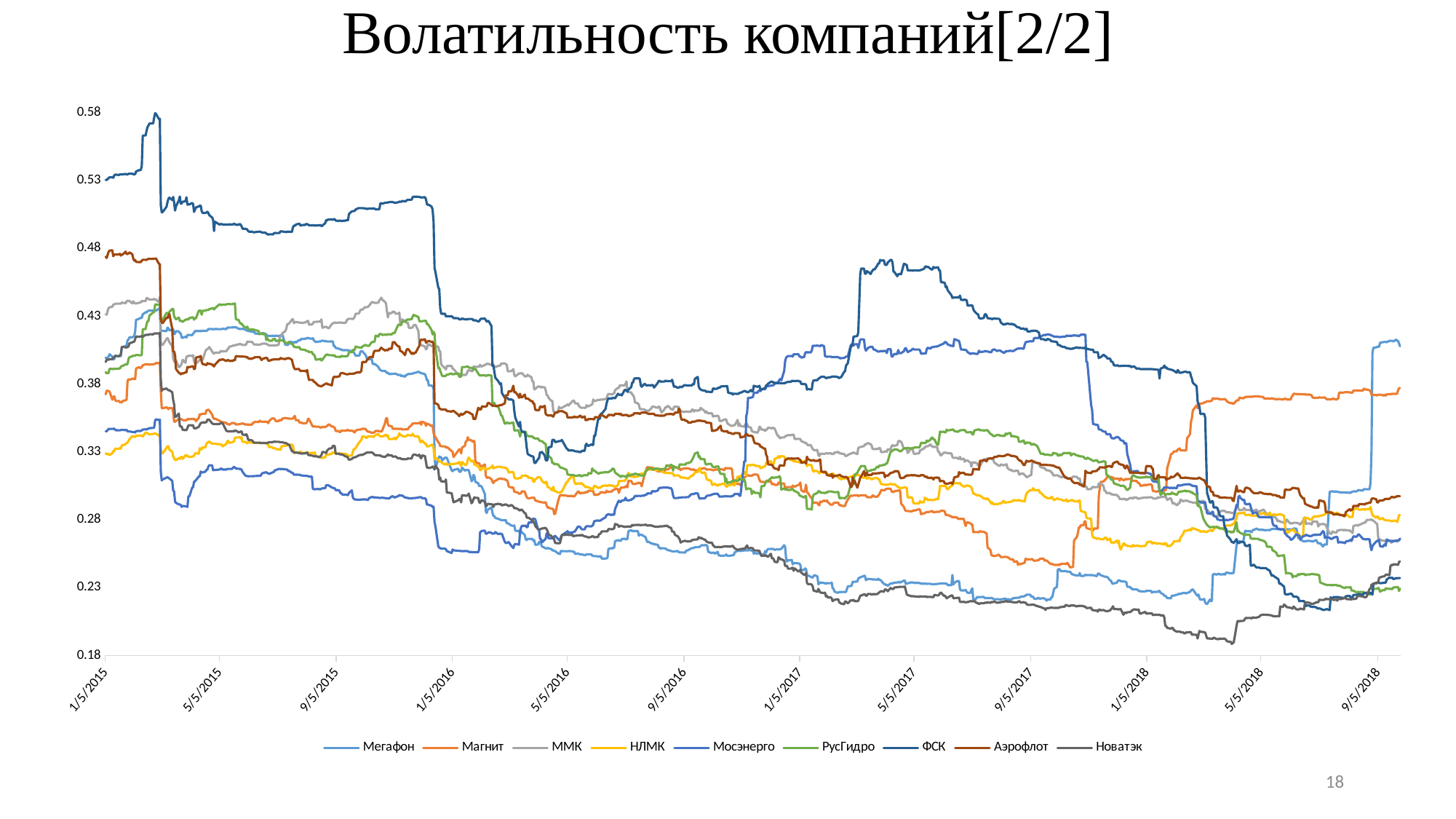
What is the title of the chart? Волатильность компаний[2/2] Is the value for Магнит at 9/5/2018 greater or less than 0.33? greater Is the value for ФСК at 1/5/2015 greater or less than 0.48? greater Which series reaches the lowest value anywhere on the chart? Новатэк What are the lowest and highest values labelled on the vertical axis? 0.18 and 0.58 How many series does the legend list? 9 Which series reaches the highest value anywhere on the chart? ФСК What kind of chart is shown on the slide? line chart Is the value for Новатэк at 9/5/2018 greater or less than 0.28? less At 9/5/2018, which is higher: Мегафон or Новатэк? Мегафон Does the ФСК series overall rise or fall from 1/5/2015 to 9/5/2018? fall